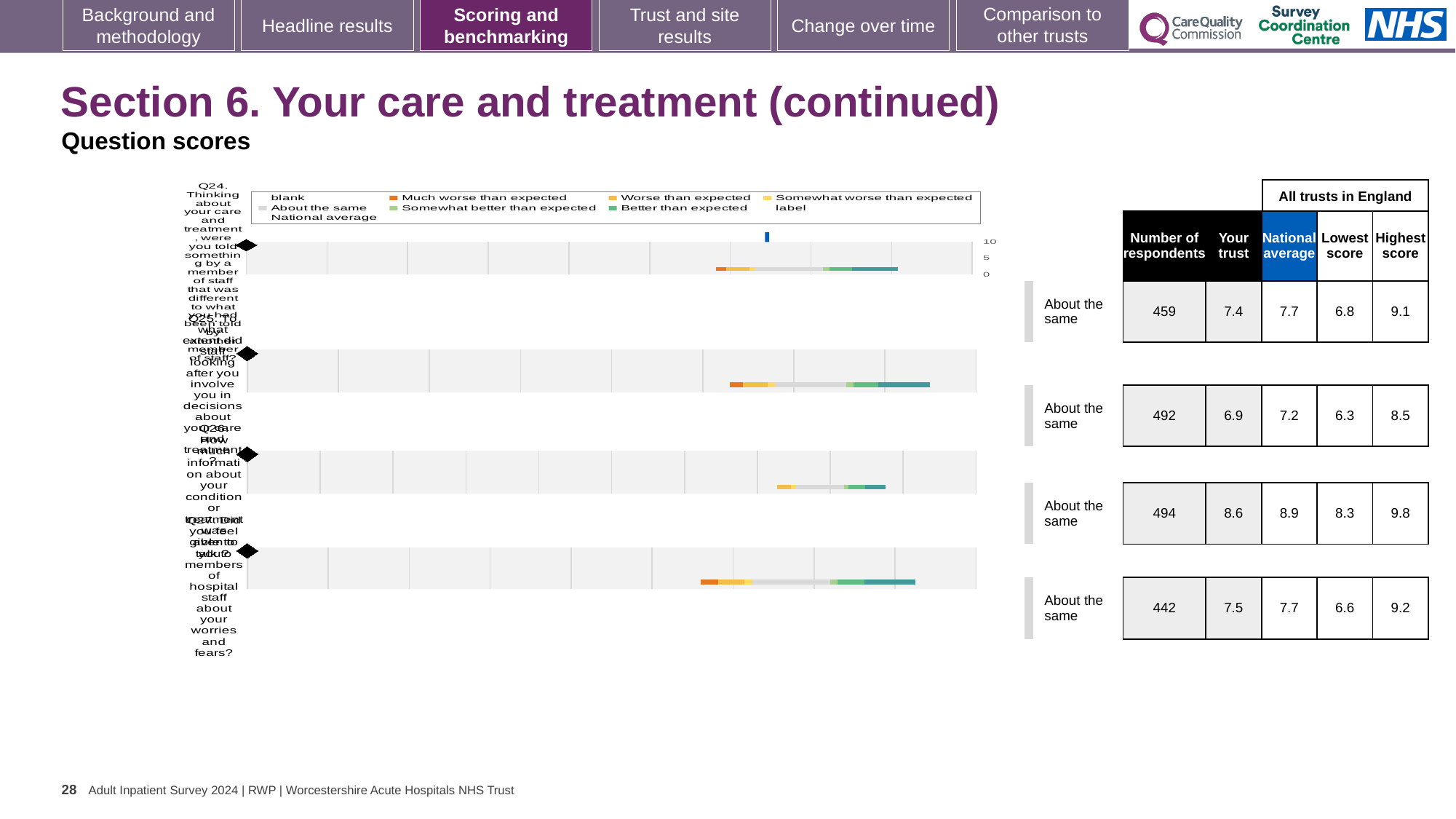
What kind of chart is used to show the question scores on this slide? bar chart What benchmark category is shown for Q25? About the same What is the national average for Q25 (staff involving you in decisions about your care and treatment)? 7.2 Which question has the lowest 'Your trust' score? Q25 For Q24, how much higher is the national average than the 'Your trust' score? 0.3 What is the highest score across all trusts in England for Q27 (able to talk to staff about worries and fears)? 9.2 Which question has the highest 'Your trust' score? Q26 Which has the larger 'Your trust' score, Q24 or Q27? Q27 What is the difference between the highest score and the lowest score for Q25? 2.2 How many questions (rows) are plotted in the question scores chart? 4 How many respondents answered Q26 (how much information about your condition or treatment was given to you)? 494 What is the 'Your trust' score for Q24 (told something different by another member of staff)? 7.4